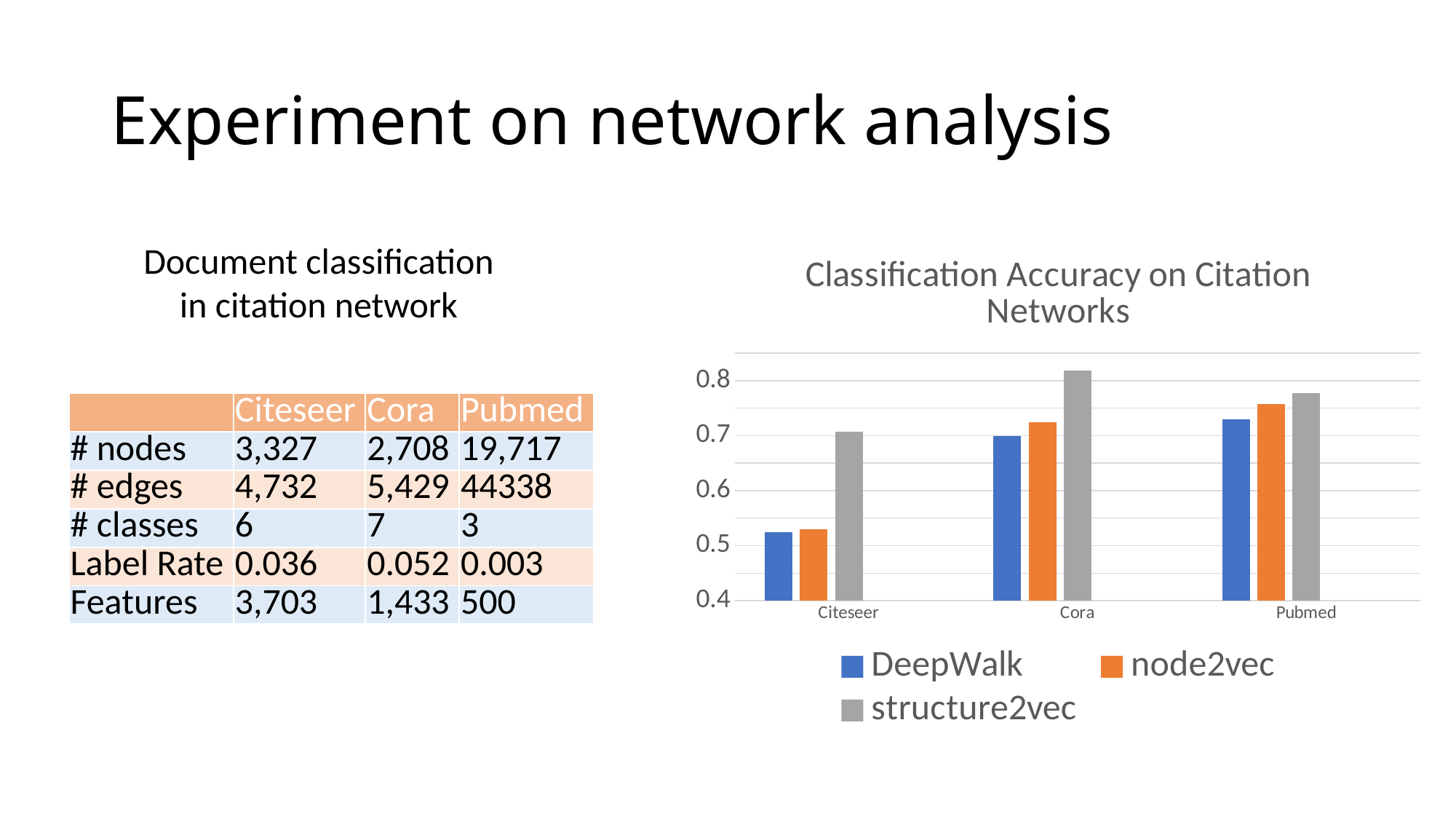
On which dataset does DeepWalk have its lowest accuracy? Citeseer Is the value for DeepWalk on Citeseer greater or less than 0.6? less Which series is shown in grey in the chart? structure2vec How many datasets (categories) are shown on the x axis of the chart? 3 Which series has the highest accuracy on Cora? structure2vec On which dataset does structure2vec reach its highest accuracy? Cora How many series does the chart legend list? 3 What kind of chart is shown on the slide? bar chart What is the title of the chart? Classification Accuracy on Citation Networks Is the value for structure2vec on Cora greater or less than 0.7? greater Is the DeepWalk accuracy higher on Citeseer or on Cora? Cora Is the structure2vec accuracy higher on Cora or on Pubmed? Cora